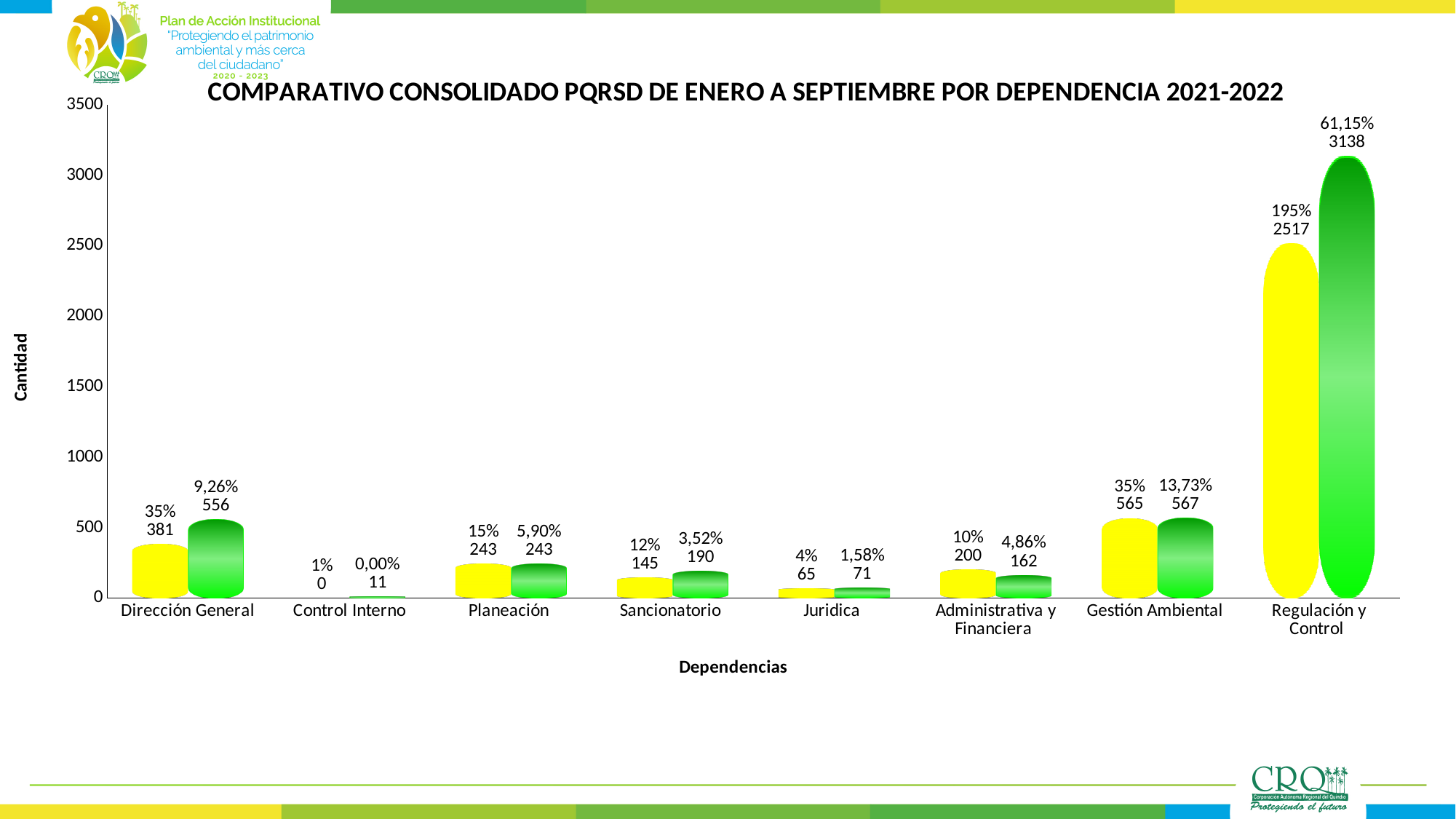
What is the difference between the green and yellow bar values for Dirección General? 175 What type of chart is shown on the slide? bar chart For Administrativa y Financiera, which is larger: the yellow bar or the green bar? the yellow bar Which dependencia has the lowest yellow bar? Control Interno What is the value of the yellow bar for Dirección General? 381 What is the difference between the green and yellow bar values for Regulación y Control? 621 Is the value of the yellow bar for Regulación y Control greater or less than 2000? greater What is the value of the green bar for Regulación y Control? 3138 How many dependencias are shown on the x axis? 8 What is the value of the yellow bar for Administrativa y Financiera? 200 What percentage label is shown above the green bar for Gestión Ambiental? 13,73% Which dependencia has the highest green bar? Regulación y Control